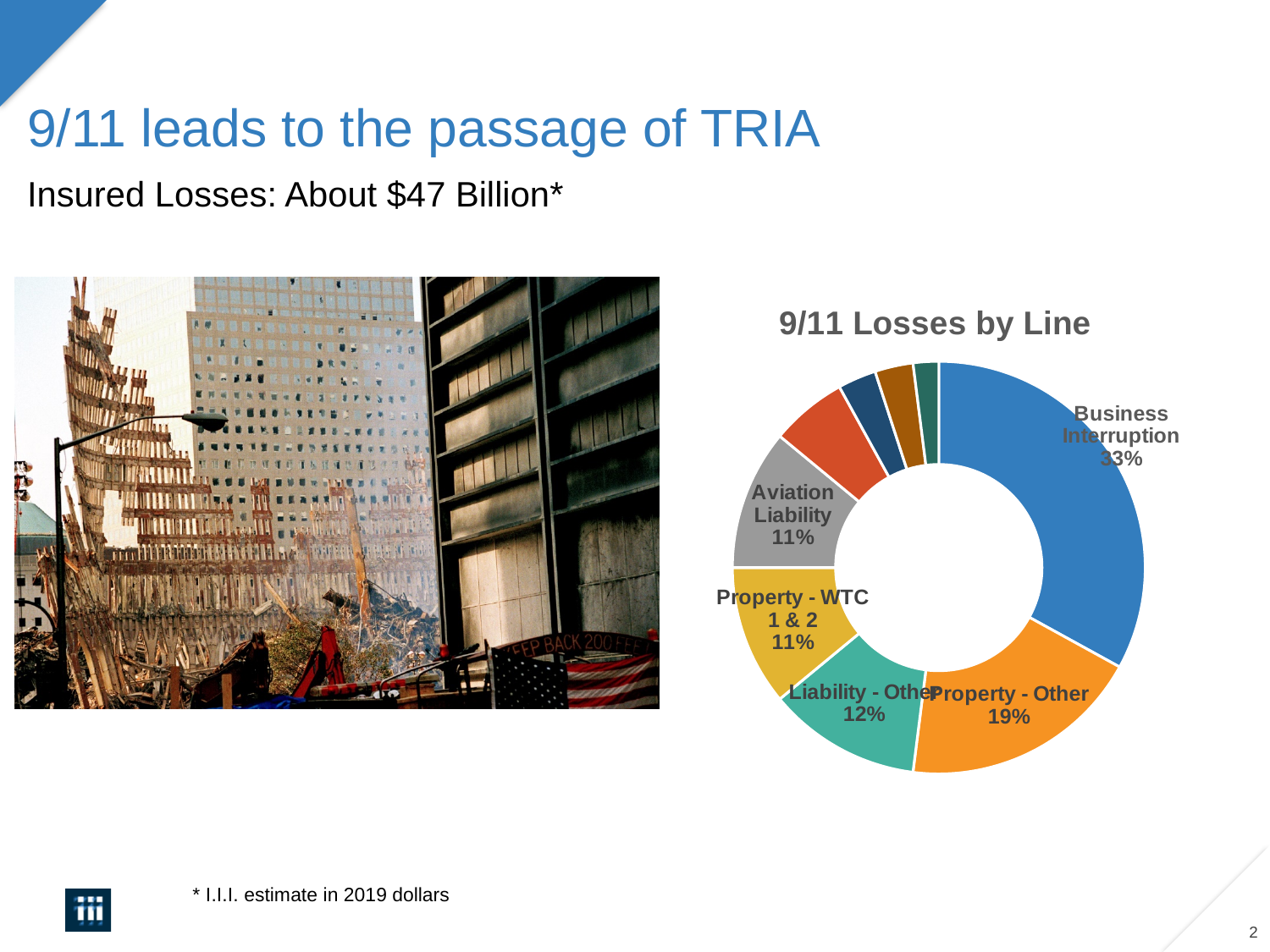
How many percentage points larger is the Liability - Other share than the Aviation Liability share? 1 percentage point What share of 9/11 losses is attributed to Property - WTC 1 & 2? 11% Which is larger: the share for Property - Other or the share for Liability - Other? Property - Other Which line of business accounts for the largest share of 9/11 losses? Business Interruption How many percentage points larger is the Business Interruption share than the Property - Other share? 14 percentage points What kind of chart is shown on the slide? Doughnut (pie) chart What share of 9/11 losses is attributed to Business Interruption? 33% What is the title of the chart on the slide? 9/11 Losses by Line What share of 9/11 losses is attributed to Liability - Other? 12% What share of 9/11 losses is attributed to Aviation Liability? 11% What colour is the Business Interruption slice in the chart? Blue What share of 9/11 losses is attributed to Property - Other? 19%